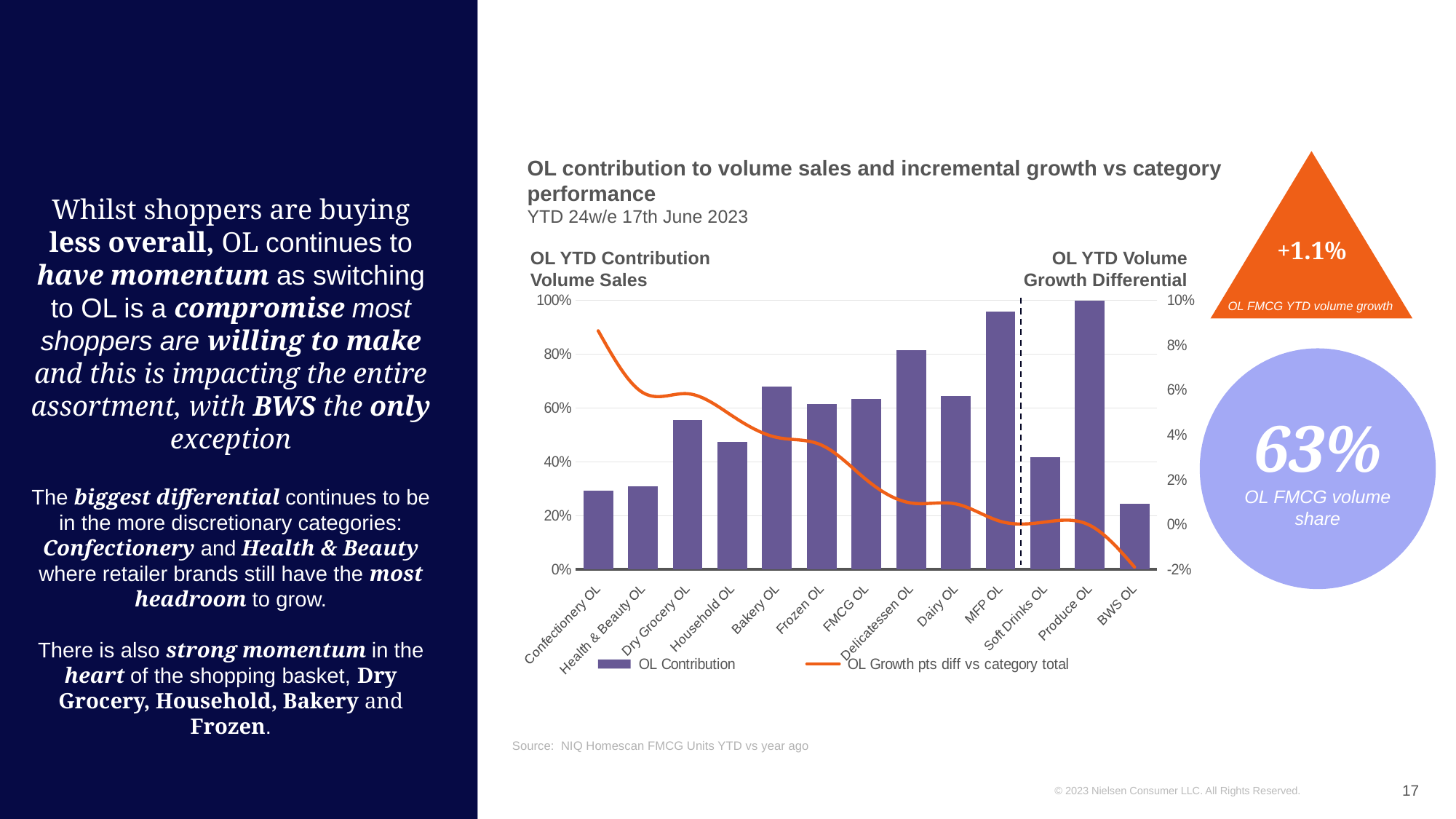
Which category has the highest OL Contribution bar? Produce OL Is the OL Contribution value for MFP OL greater or less than 80%? greater How many series does the chart legend list? 2 What is the title of the chart? OL contribution to volume sales and incremental growth vs category performance Is the OL Contribution value for Soft Drinks OL greater or less than 60%? less Is the OL Contribution value for Bakery OL greater or less than 60%? greater Which category has the lowest OL Contribution bar? BWS OL What are the two series named in the chart legend? OL Contribution; OL Growth pts diff vs category total Which has the larger OL Contribution bar, Delicatessen OL or Dairy OL? Delicatessen OL Does the OL Growth pts diff vs category total line generally rise or fall from left to right across the categories? fall How many categories are shown on the x axis of the chart? 13